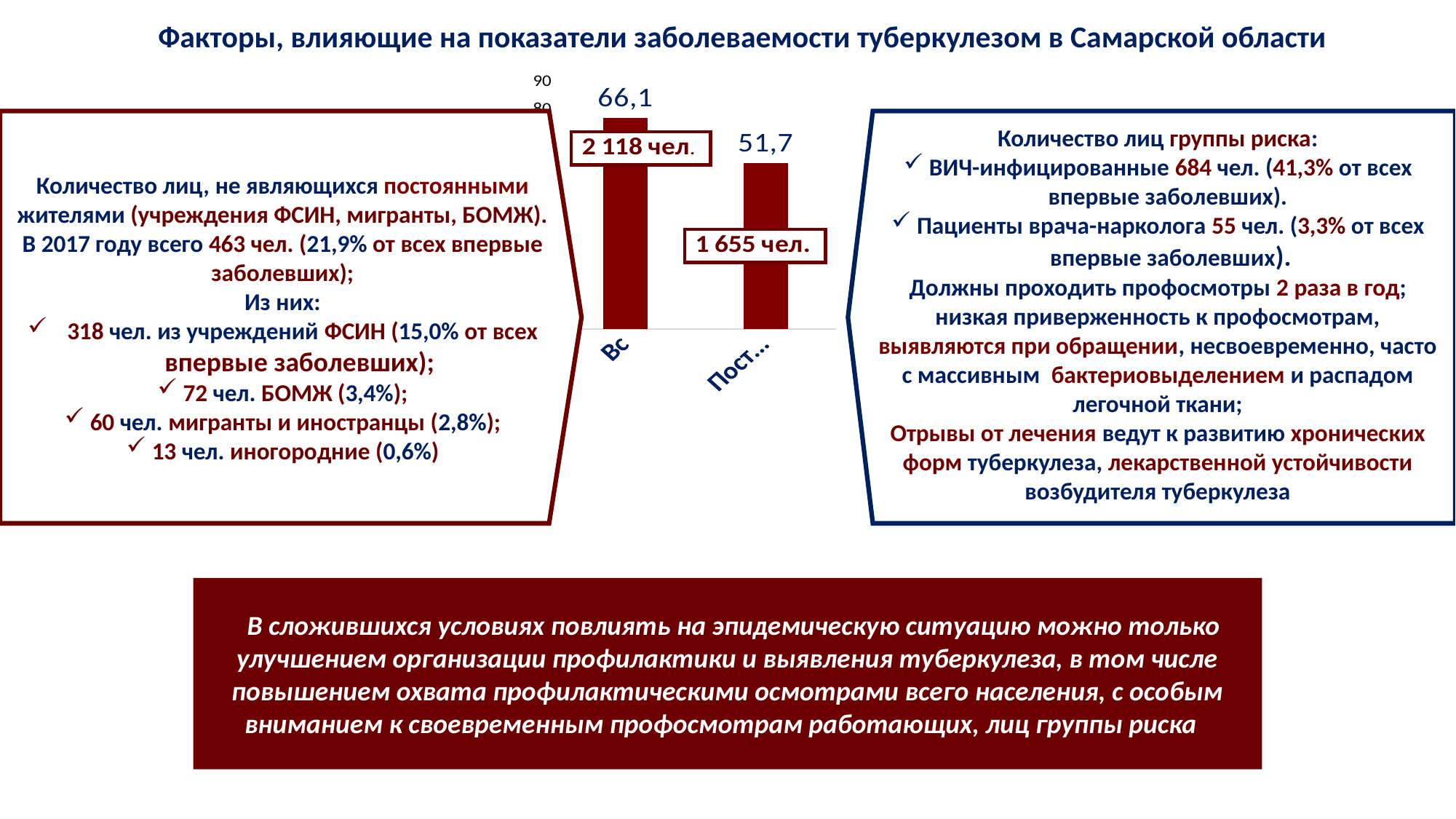
What value is labelled on the right bar of the chart? 51,7 Which bar has the highest value, the left one or the right one? the left one Do the bar values rise or fall from left to right? fall What is the difference between the values of the left bar (66,1) and the right bar (51,7)? 14,4 What value is labelled on the left bar of the chart? 66,1 What colour are the bars in the chart? dark red How many bars does the chart contain? 2 Is the value of the left bar larger or smaller than the value of the right bar? larger What kind of chart is shown on the slide? bar chart What text is shown in the box overlaid on the left bar of the chart? 2 118 чел. Which bar has the lowest value, the left one or the right one? the right one